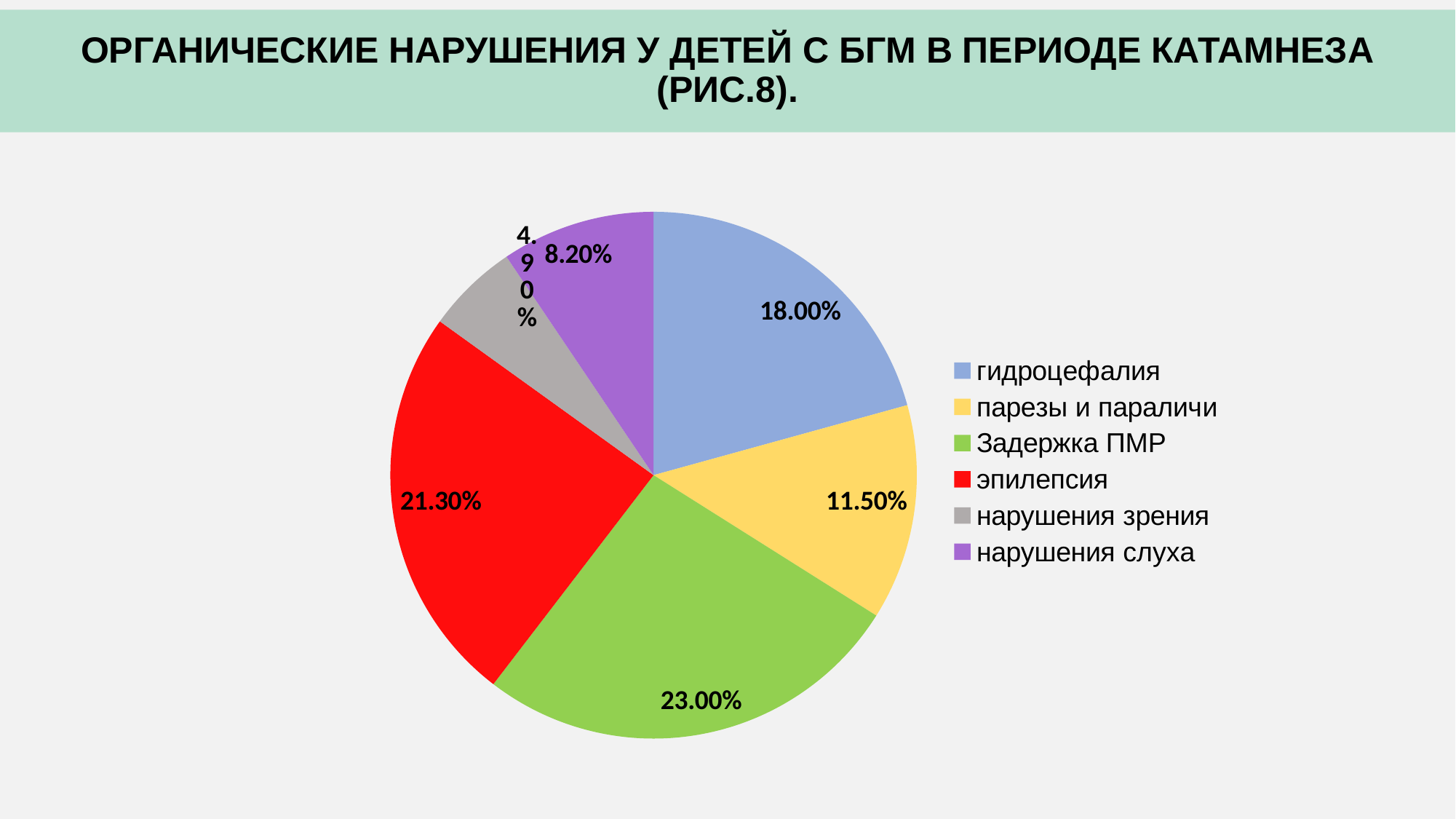
Which category has the smallest slice? нарушения зрения What colour is the slice for эпилепсия? red Which category has the largest slice? Задержка ПМР What is the difference between the values for Задержка ПМР and эпилепсия? 1.70% What is the value for парезы и параличи? 11.50% What is the value for Задержка ПМР? 23.00% What is the value for гидроцефалия? 18.00% What is the value for нарушения слуха? 8.20% Which is larger, the value for гидроцефалия or the value for парезы и параличи? гидроцефалия How many categories does the pie chart have? 6 What kind of chart is shown on the slide? pie chart What is the value for эпилепсия? 21.30%